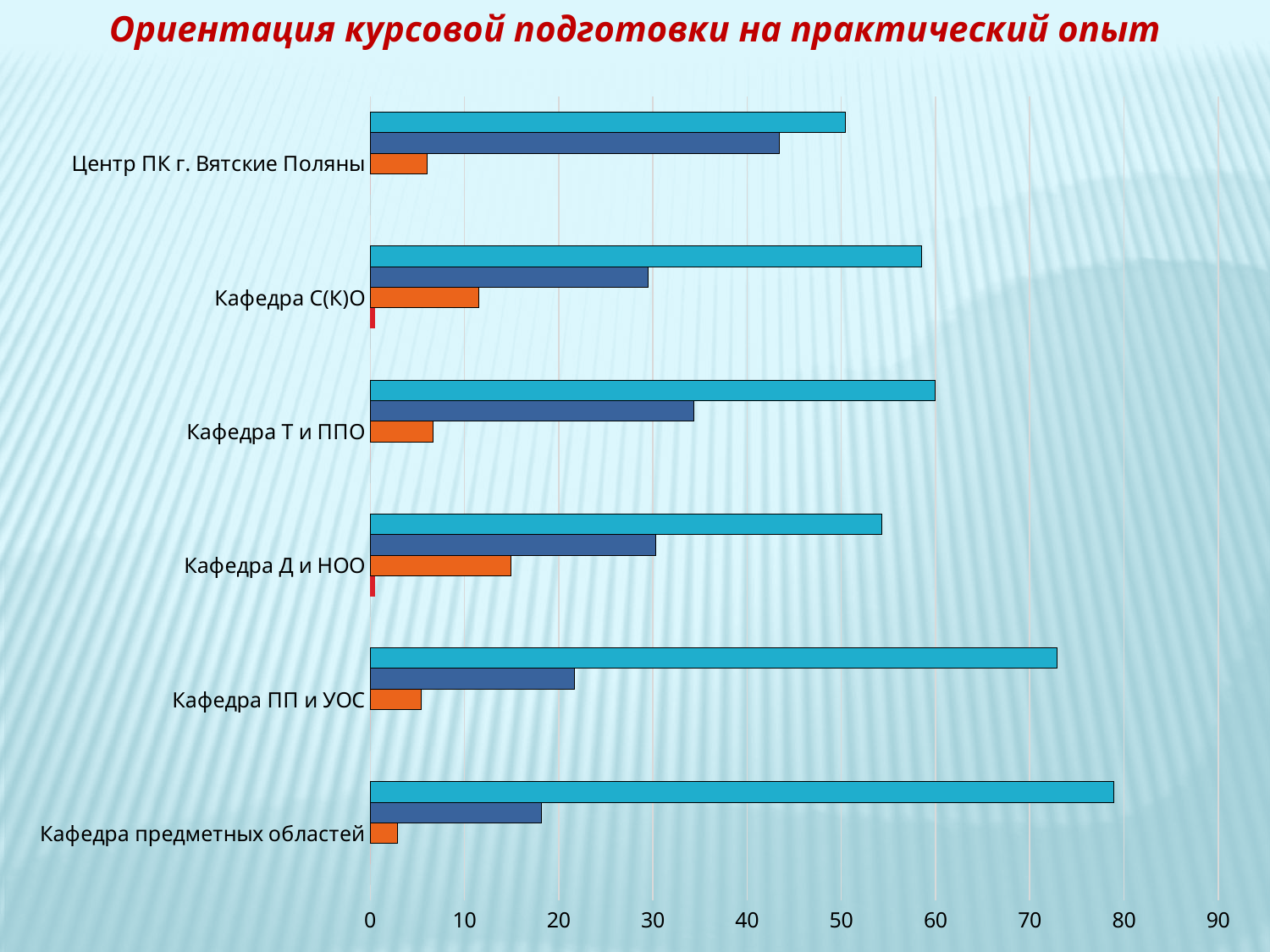
Which category has the longest light blue bar? Кафедра предметных областей Which category has the shortest light blue bar? Центр ПК г. Вятские Поляны Which is larger: the dark blue bar for Кафедра Т и ППО or the dark blue bar for Кафедра ПП и УОС? Кафедра Т и ППО Is the light blue bar for Центр ПК г. Вятские Поляны greater or less than 60? less Is the light blue bar for Кафедра ПП и УОС greater or less than 70? greater Which category has the shortest dark blue bar? Кафедра предметных областей Which category has the longest orange bar? Кафедра Д и НОО Is the dark blue bar for Кафедра предметных областей greater or less than 20? less What kind of chart is shown on the slide? bar chart What is the title of the slide containing the chart? Ориентация курсовой подготовки на практический опыт How many categories are shown on the vertical axis of the chart? 6 Which category has the longest dark blue bar? Центр ПК г. Вятские Поляны